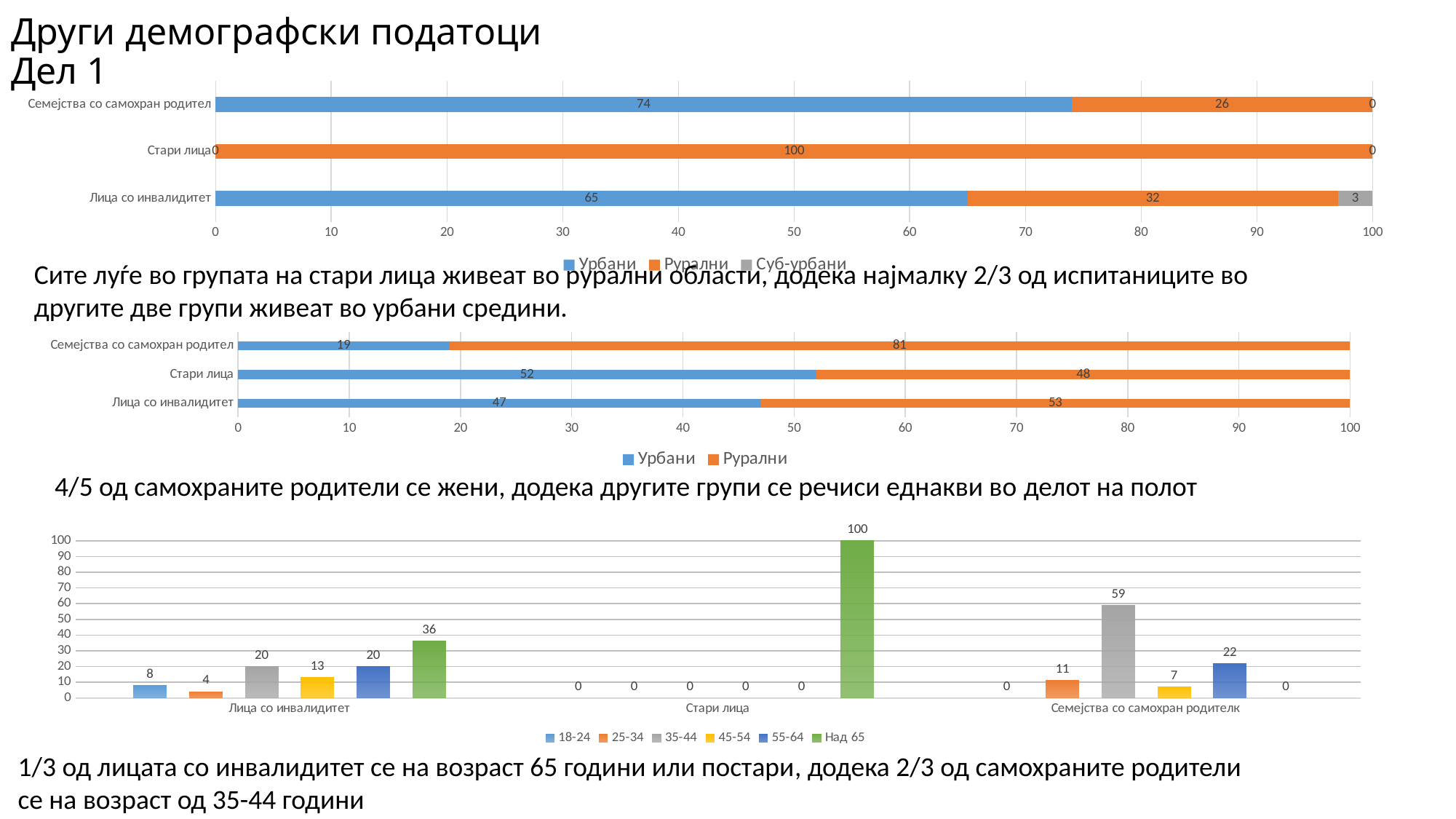
In the top chart, what is the value for Суб-урбани for Лица со инвалидитет? 3 In the middle chart, what is the difference between the Урбани values for Стари лица and Семејства со самохран родител? 33 What kind of chart is the bottom chart? Bar chart In the top chart, what is the value for Рурални for Стари лица? 100 In the middle chart, which category has the highest Урбани value? Стари лица How many series does the legend of the bottom chart list? 6 In the bottom chart, what is the value for 35-44 for Семејства со самохран родителк? 59 In the top chart, what is the value for Урбани for Семејства со самохран родител? 74 In the middle chart, which is larger for Лица со инвалидитет: Урбани or Рурални? Рурални In the bottom chart, what is the value for Над 65 for Лица со инвалидитет? 36 How many series does the legend of the top chart list? 3 In the middle chart, what is the value for Рурални for Семејства со самохран родител? 81